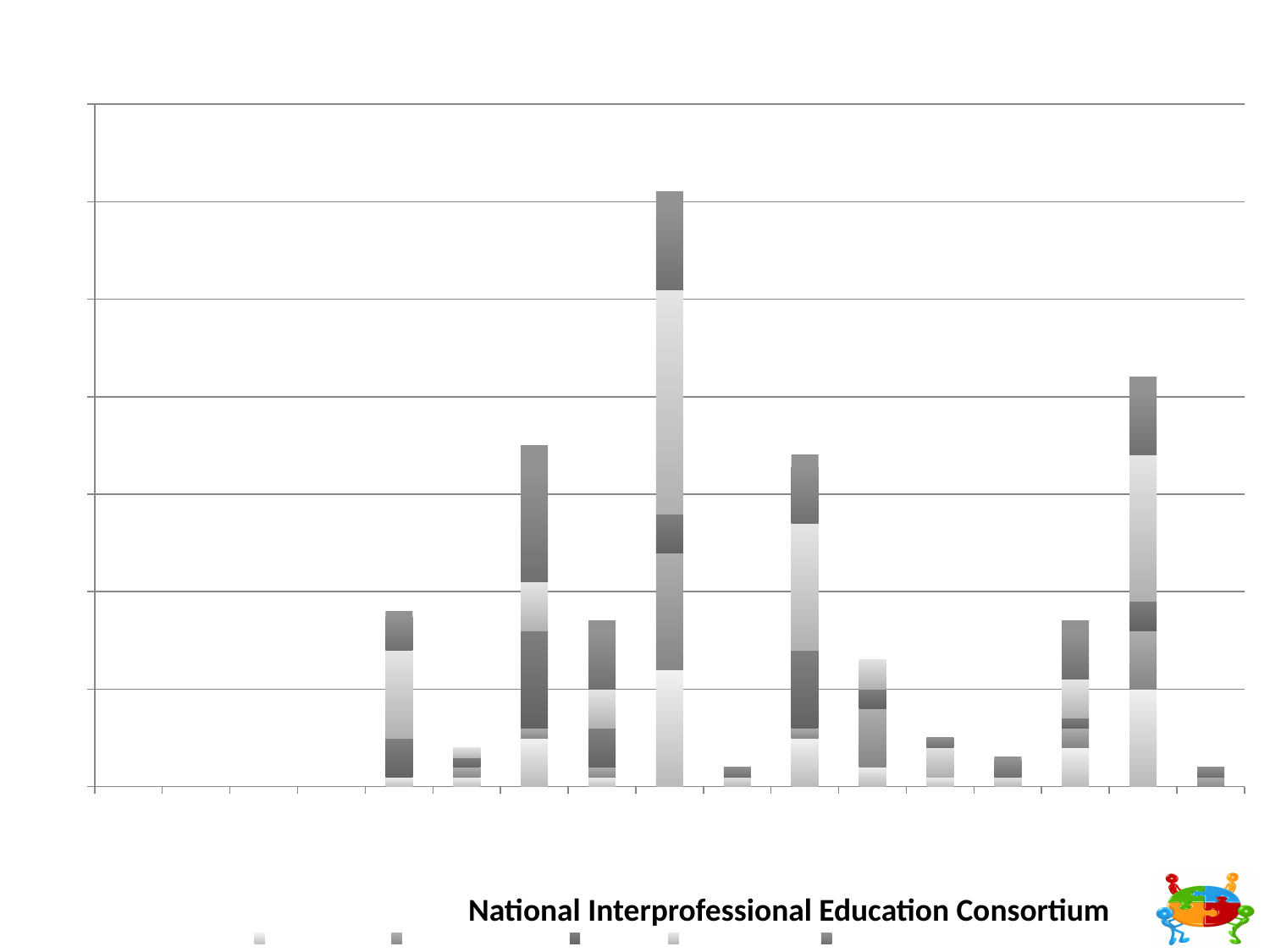
How many series does the legend below the chart list? 5 Counting only the bars with visible values from the left, which is taller: the fifth bar or the seventh bar? the fifth bar How many stacked bars with visible values are plotted in the chart? 13 Counting only the bars with visible values from the left, which bar is the tallest? the fifth bar Counting only the bars with visible values from the left, which is taller: the first bar or the third bar? the third bar Are the legend entries below the chart shown with readable text labels? No Counting only the bars with visible values from the left, which is taller: the twelfth bar or the eleventh bar? the twelfth bar What kind of chart is shown on the slide? stacked bar chart Does the chart display a title above the plot area? No